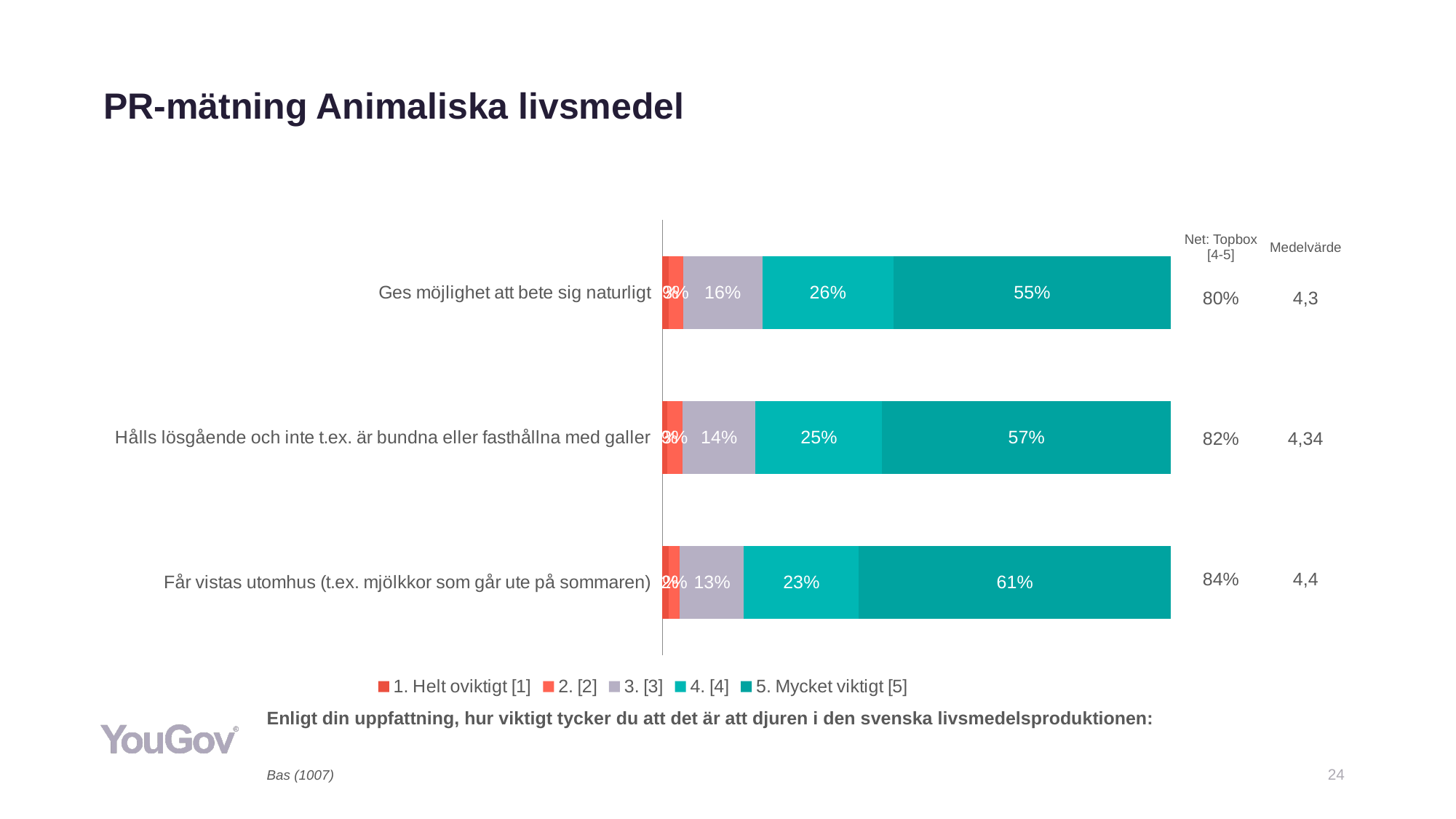
Which category has the lowest value for '3. [3]'? Får vistas utomhus (t.ex. mjölkkor som går ute på sommaren) What is the value of '5. Mycket viktigt [5]' for 'Får vistas utomhus (t.ex. mjölkkor som går ute på sommaren)'? 61% Which category has the highest value for '5. Mycket viktigt [5]'? Får vistas utomhus (t.ex. mjölkkor som går ute på sommaren) What is the 'Net: Topbox [4-5]' value for 'Hålls lösgående och inte t.ex. är bundna eller fasthållna med galler'? 82% How many series does the legend list? 5 How many categories (statements) are shown in the chart? 3 What is the value of '4. [4]' for 'Ges möjlighet att bete sig naturligt'? 26% Which is larger: the '4. [4]' value for 'Ges möjlighet att bete sig naturligt' or for 'Hålls lösgående och inte t.ex. är bundna eller fasthållna med galler'? Ges möjlighet att bete sig naturligt What is the value of '3. [3]' for 'Hålls lösgående och inte t.ex. är bundna eller fasthållna med galler'? 14% What is the difference between the '5. Mycket viktigt [5]' values for 'Får vistas utomhus' and 'Ges möjlighet att bete sig naturligt'? 6% What kind of chart is shown on the slide? bar chart What is the 'Medelvärde' for 'Får vistas utomhus (t.ex. mjölkkor som går ute på sommaren)'? 4,4